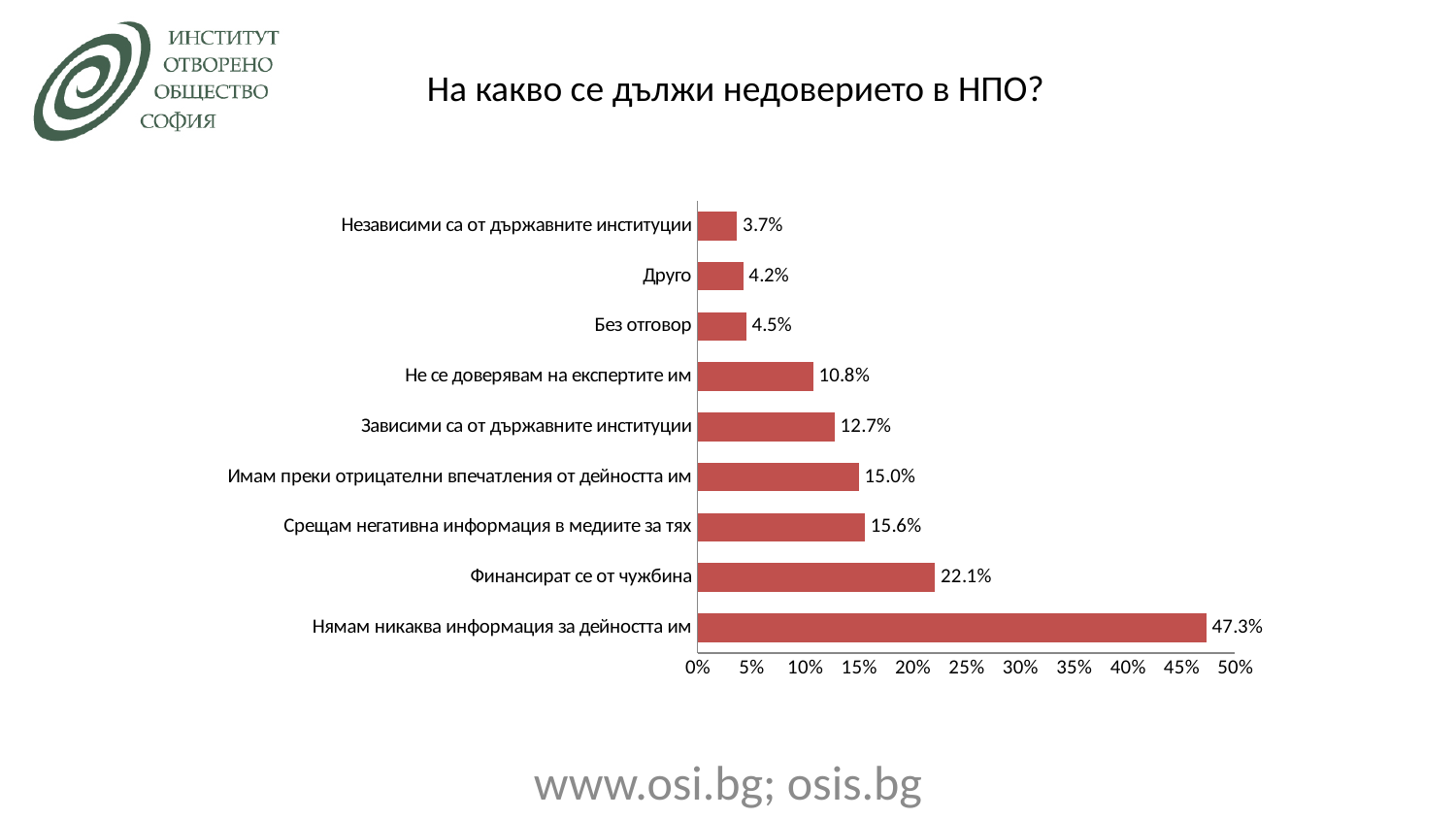
Is the value for "Срещам негативна информация в медиите за тях" greater or less than 20%? less Which category has the lowest value? Независими са от държавните институции What is the value for "Не се доверявам на експертите им"? 10.8% What is the difference between "Нямам никаква информация за дейността им" and "Финансират се от чужбина"? 25.2% How many categories are shown in the chart? 9 What kind of chart is shown on the slide? bar chart What is the value for "Финансират се от чужбина"? 22.1% What is the value for "Друго"? 4.2% Which category has the highest value? Нямам никаква информация за дейността им What is the value for "Нямам никаква информация за дейността им"? 47.3% Which is larger: "Зависими са от държавните институции" or "Не се доверявам на експертите им"? Зависими са от държавните институции What is the title of the chart? На какво се дължи недоверието в НПО?